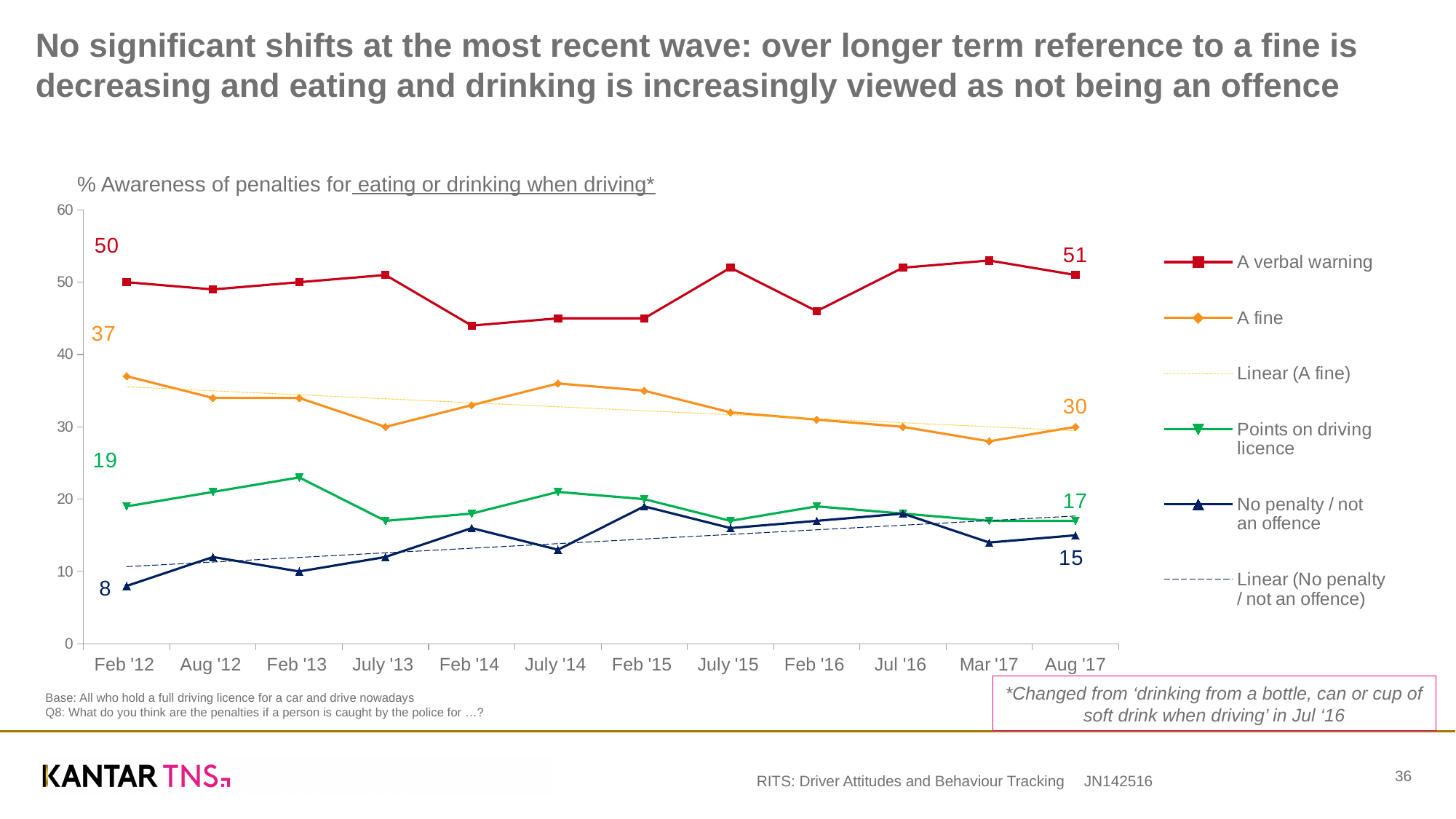
Is the value for 'A fine' at Feb '12 larger or smaller than its value at Aug '17? larger What is the value for 'Points on driving licence' at Aug '17? 17 Which series has the lowest value at Feb '12? No penalty / not an offence How many time points are shown on the x axis? 12 How many entries does the legend list? 6 By how much did the value for 'A fine' fall between Feb '12 and Aug '17? 7 What is the value for 'A verbal warning' at Feb '12? 50 What is the value for 'A fine' at Aug '17? 30 What is the value for 'No penalty / not an offence' at Feb '12? 8 What kind of chart is shown on the slide? line chart Is the value for 'A verbal warning' at Feb '14 greater or less than 50? less Which series has the highest value at Aug '17? A verbal warning